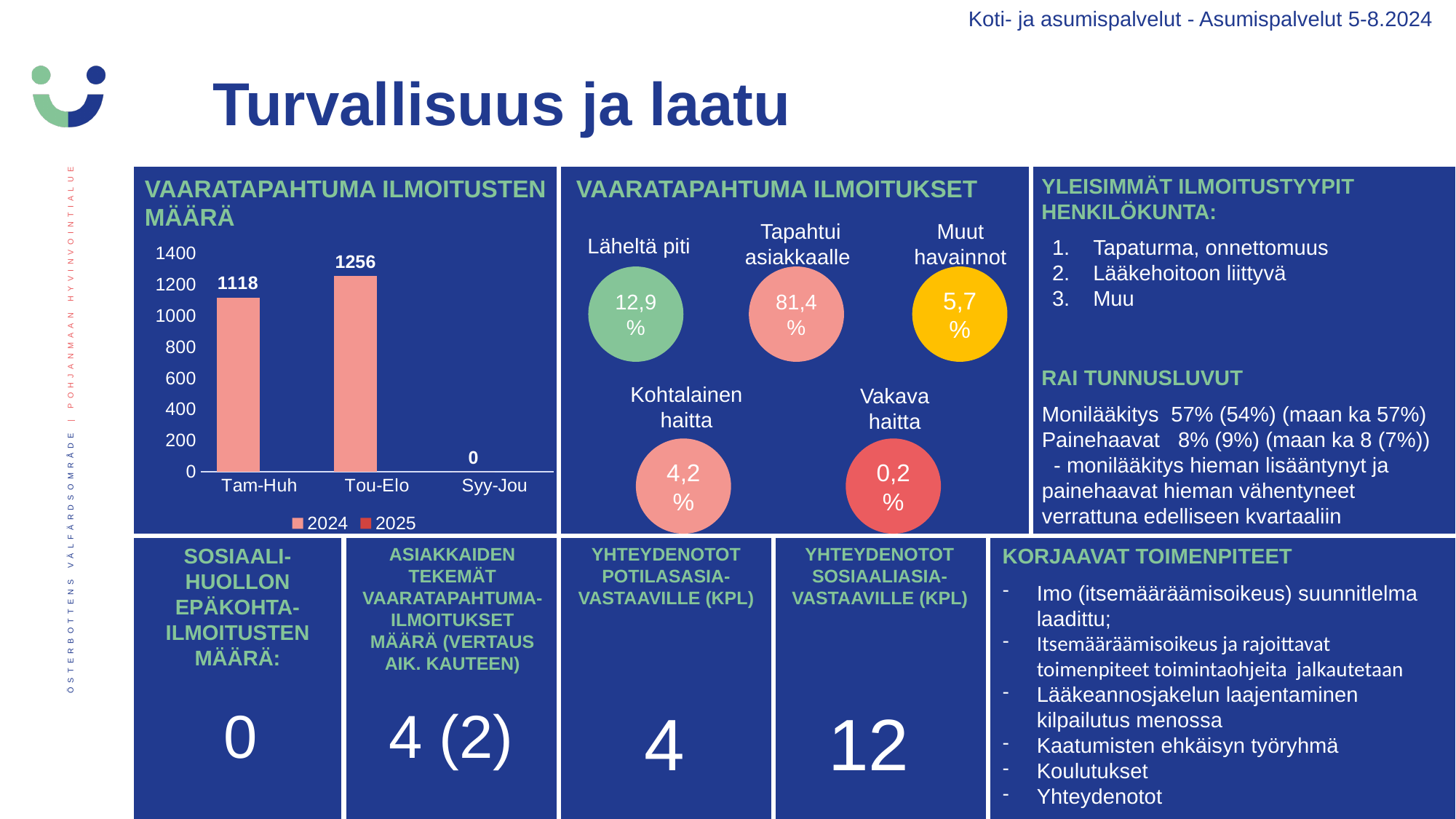
In the chart titled "VAARATAPAHTUMA ILMOITUSTEN MÄÄRÄ", what is the value for Syy-Jou? 0 In the chart titled "VAARATAPAHTUMA ILMOITUSTEN MÄÄRÄ", which category has the lowest value? Syy-Jou How many series does the legend of the chart titled "VAARATAPAHTUMA ILMOITUSTEN MÄÄRÄ" list? 2 In the chart titled "VAARATAPAHTUMA ILMOITUSTEN MÄÄRÄ", which is larger, the value for Tam-Huh or the value for Tou-Elo? Tou-Elo In the chart titled "VAARATAPAHTUMA ILMOITUSTEN MÄÄRÄ", what is the difference between the values for Tou-Elo and Tam-Huh? 138 What are the legend entries of the chart titled "VAARATAPAHTUMA ILMOITUSTEN MÄÄRÄ"? 2024 and 2025 In the chart titled "VAARATAPAHTUMA ILMOITUSTEN MÄÄRÄ", what is the value for Tou-Elo? 1256 How many categories are shown on the x axis of the chart titled "VAARATAPAHTUMA ILMOITUSTEN MÄÄRÄ"? 3 What kind of chart is the chart titled "VAARATAPAHTUMA ILMOITUSTEN MÄÄRÄ"? bar chart In the chart titled "VAARATAPAHTUMA ILMOITUSTEN MÄÄRÄ", which category has the highest value? Tou-Elo In the chart titled "VAARATAPAHTUMA ILMOITUSTEN MÄÄRÄ", what is the value for Tam-Huh? 1118 In the chart titled "VAARATAPAHTUMA ILMOITUSTEN MÄÄRÄ", is the value for Tam-Huh greater or less than 1000? greater